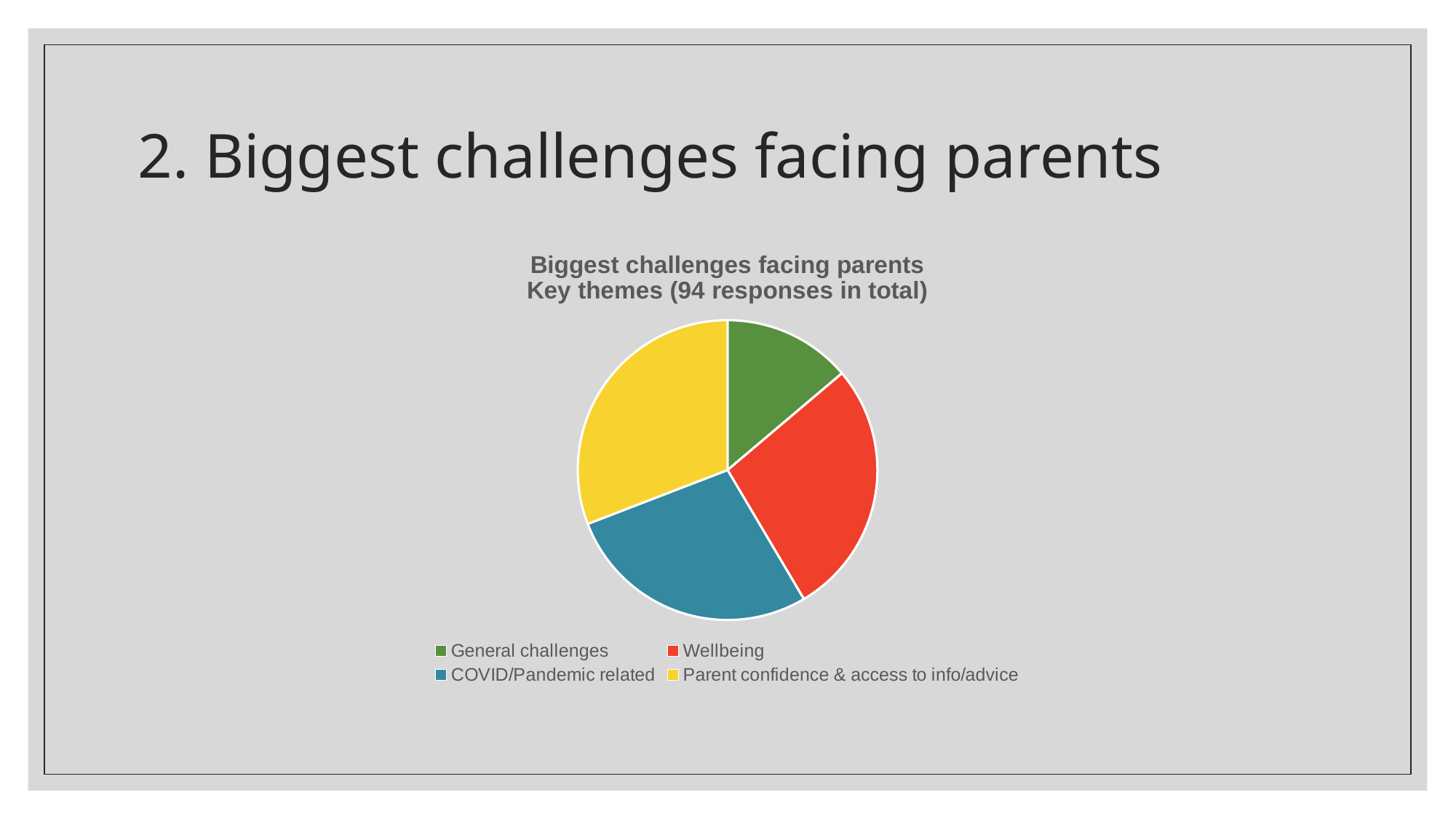
According to the chart title, how many responses were there in total? 94 What colour is the Wellbeing slice in the pie chart? red Which slice is larger: General challenges or Parent confidence & access to info/advice? Parent confidence & access to info/advice Which category has the smallest slice in the pie chart? General challenges What kind of chart is shown on the slide? pie chart Which slice is larger: COVID/Pandemic related or General challenges? COVID/Pandemic related How many entries does the legend of the pie chart list? 4 How many slices does the pie chart have? 4 Which slice is larger: General challenges or Wellbeing? Wellbeing